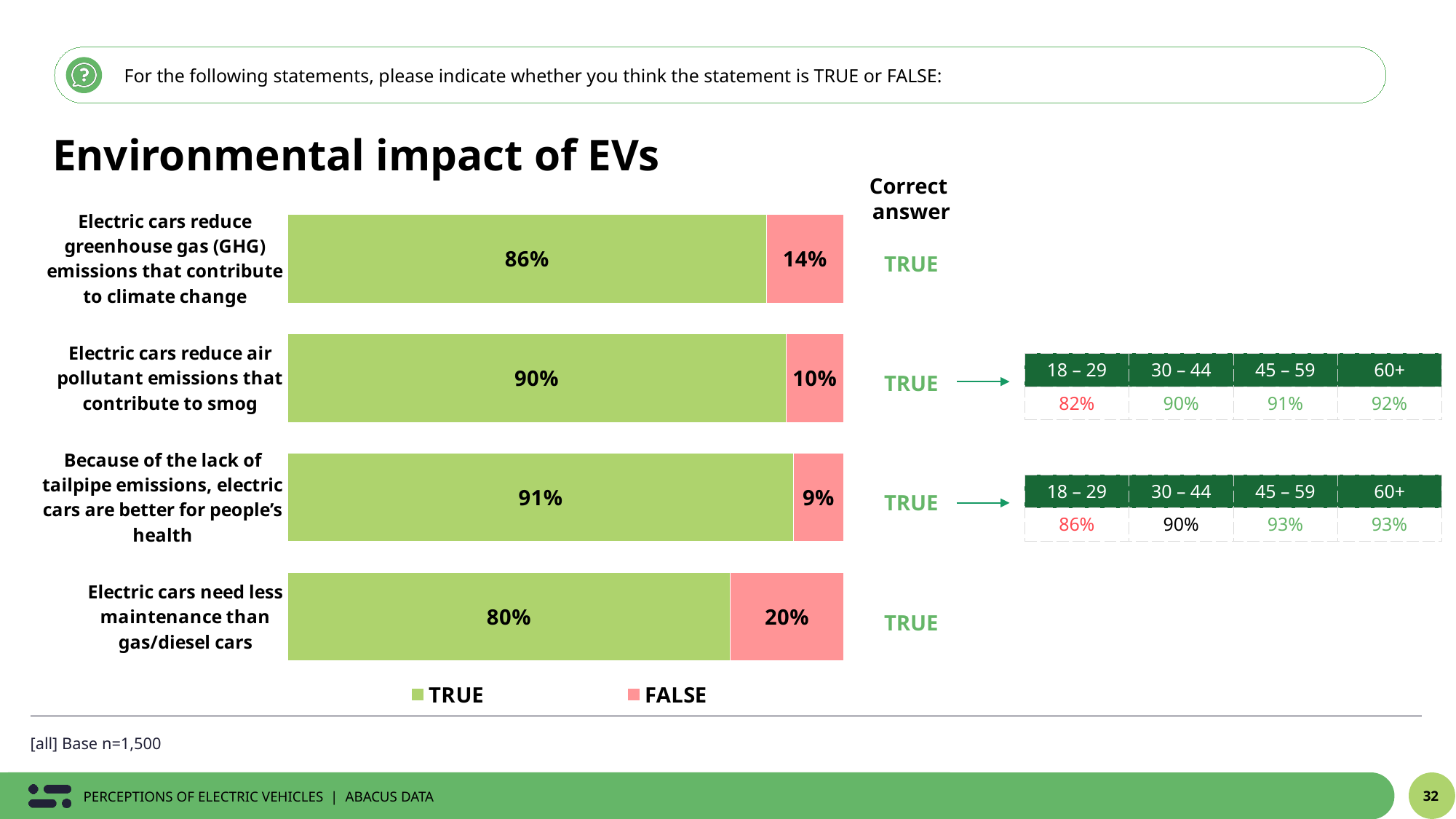
What is the total of the TRUE and FALSE segments for the 'need less maintenance' statement? 100% Which statement has the highest share of TRUE responses? Because of the lack of tailpipe emissions, electric cars are better for people's health Which has a larger FALSE share: the greenhouse gas statement or the smog statement? The greenhouse gas statement What is the difference in TRUE responses between the 'better for people's health' statement and the 'need less maintenance' statement? 11 percentage points What percentage of respondents said TRUE for the statement 'Electric cars reduce greenhouse gas (GHG) emissions that contribute to climate change'? 86% How many statements are shown in the bar chart? 4 What type of chart is used to show the TRUE/FALSE responses? Stacked bar chart What percentage of respondents said TRUE for the statement 'Electric cars reduce air pollutant emissions that contribute to smog'? 90% How many series does the legend list? 2 What colour represents FALSE responses in the chart? Pink/red What percentage of respondents said FALSE for the statement 'Electric cars need less maintenance than gas/diesel cars'? 20% Which statement has the lowest share of TRUE responses? Electric cars need less maintenance than gas/diesel cars